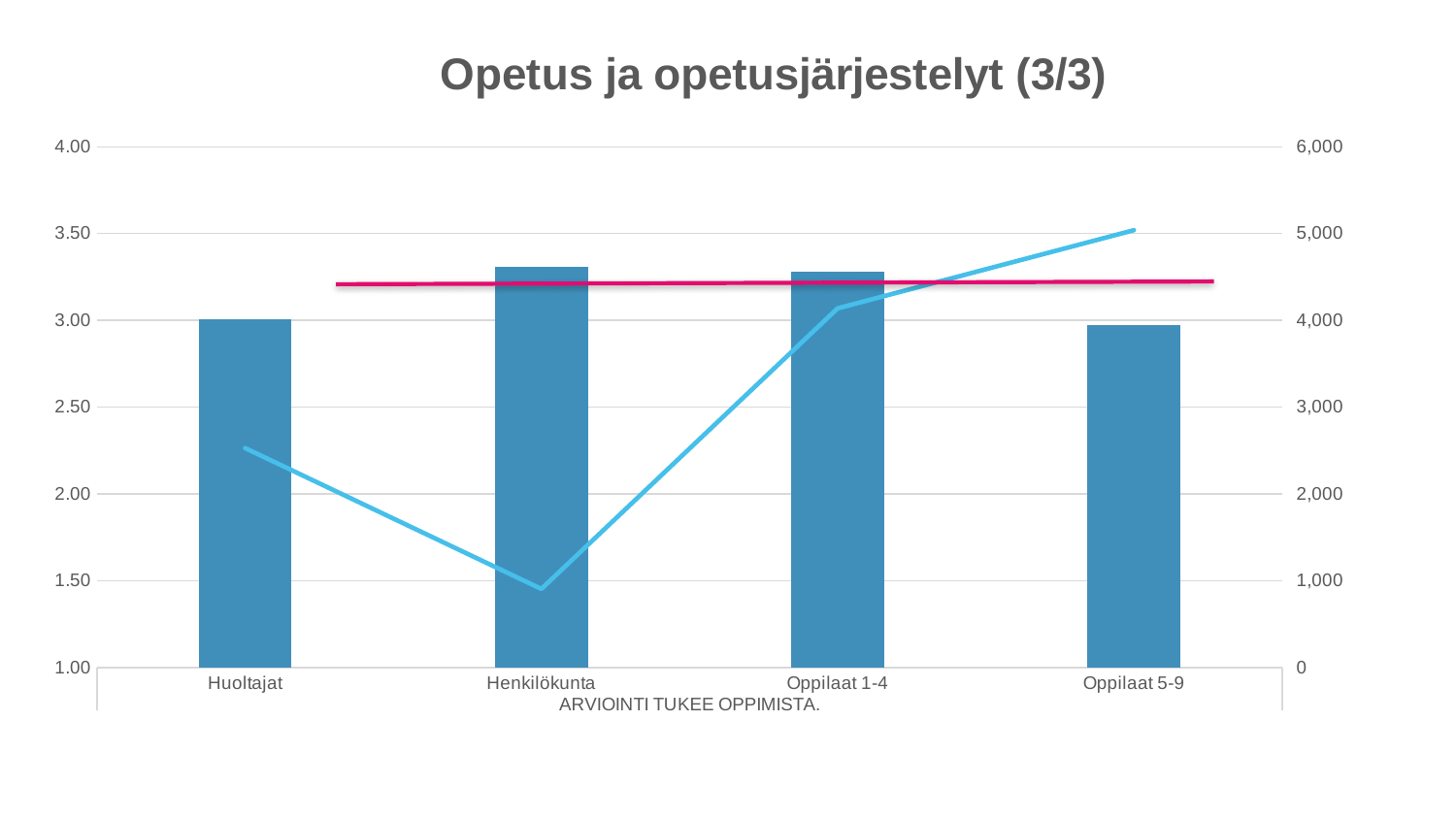
Is the bar for Oppilaat 5-9 greater or less than 3.50 on the left axis? less What is the title of the chart? Opetus ja opetusjärjestelyt (3/3) What kind of chart is this? Bar chart with line series Which bar is taller, Oppilaat 1-4 or Oppilaat 5-9? Oppilaat 1-4 Is the light blue line's value for Henkilökunta greater or less than 1,000 on the right axis? less Which bar is taller, Henkilökunta or Huoltajat? Henkilökunta At which category does the light blue line reach its highest point? Oppilaat 5-9 Is the bar for Henkilökunta greater or less than 3.00 on the left axis? greater What text appears as the x-axis label below the categories? ARVIOINTI TUKEE OPPIMISTA. At which category does the light blue line reach its lowest point? Henkilökunta Does the light blue line rise or fall from Henkilökunta to Oppilaat 5-9? rise How many categories are shown on the x axis? 4